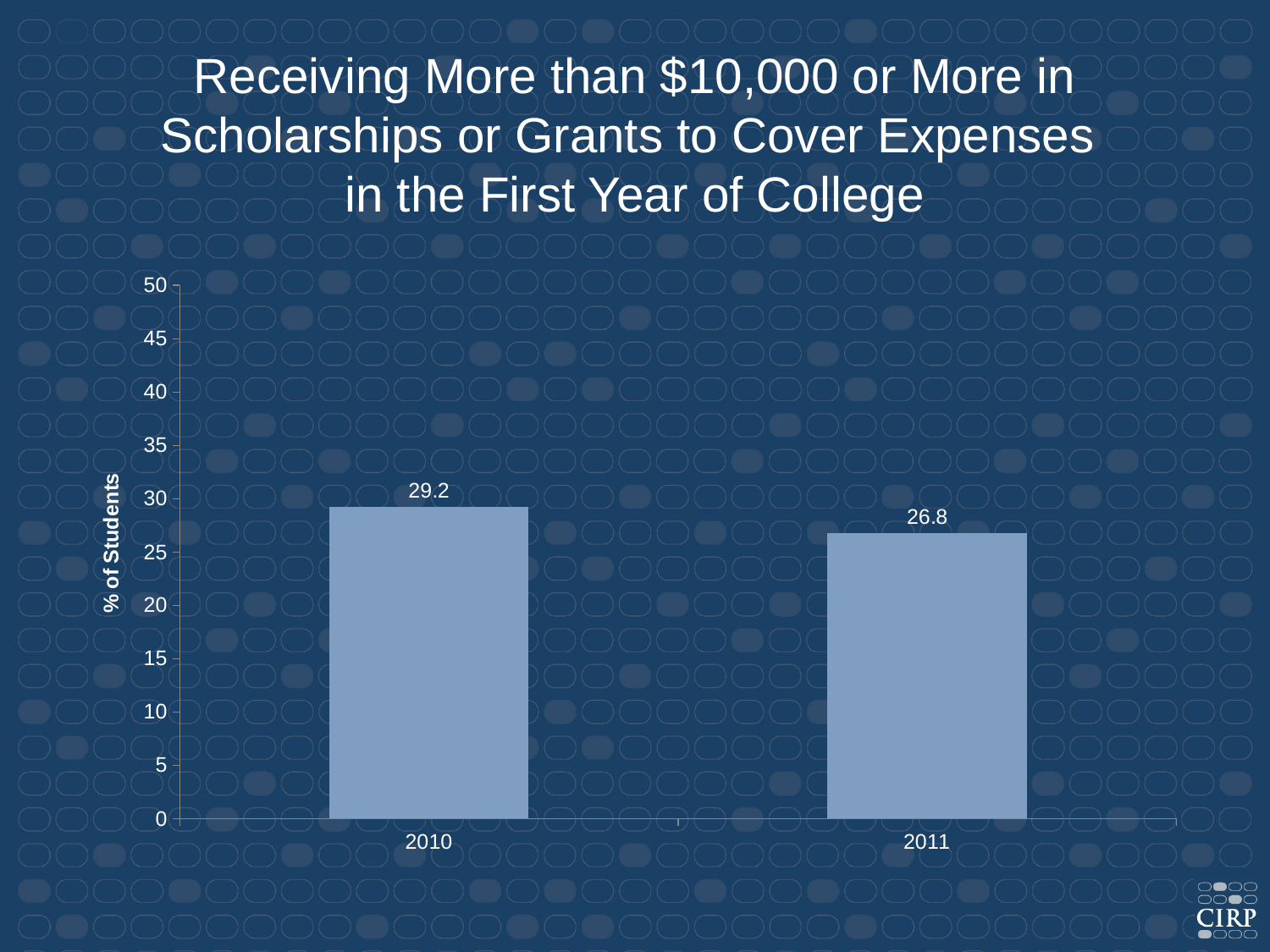
What is the value for 2010? 29.2 What is the difference between the values for 2010 and 2011? 2.4 What is the label of the y axis? % of Students How many categories are shown on the x axis? 2 Do the values rise or fall from 2010 to 2011? fall Which year has the lowest value? 2011 Is the value for 2010 greater or less than 25? greater Is the value for 2011 greater or less than 30? less Which is larger, the value for 2010 or the value for 2011? 2010 What is the value for 2011? 26.8 What kind of chart is shown on the slide? bar chart Which year has the highest value? 2010